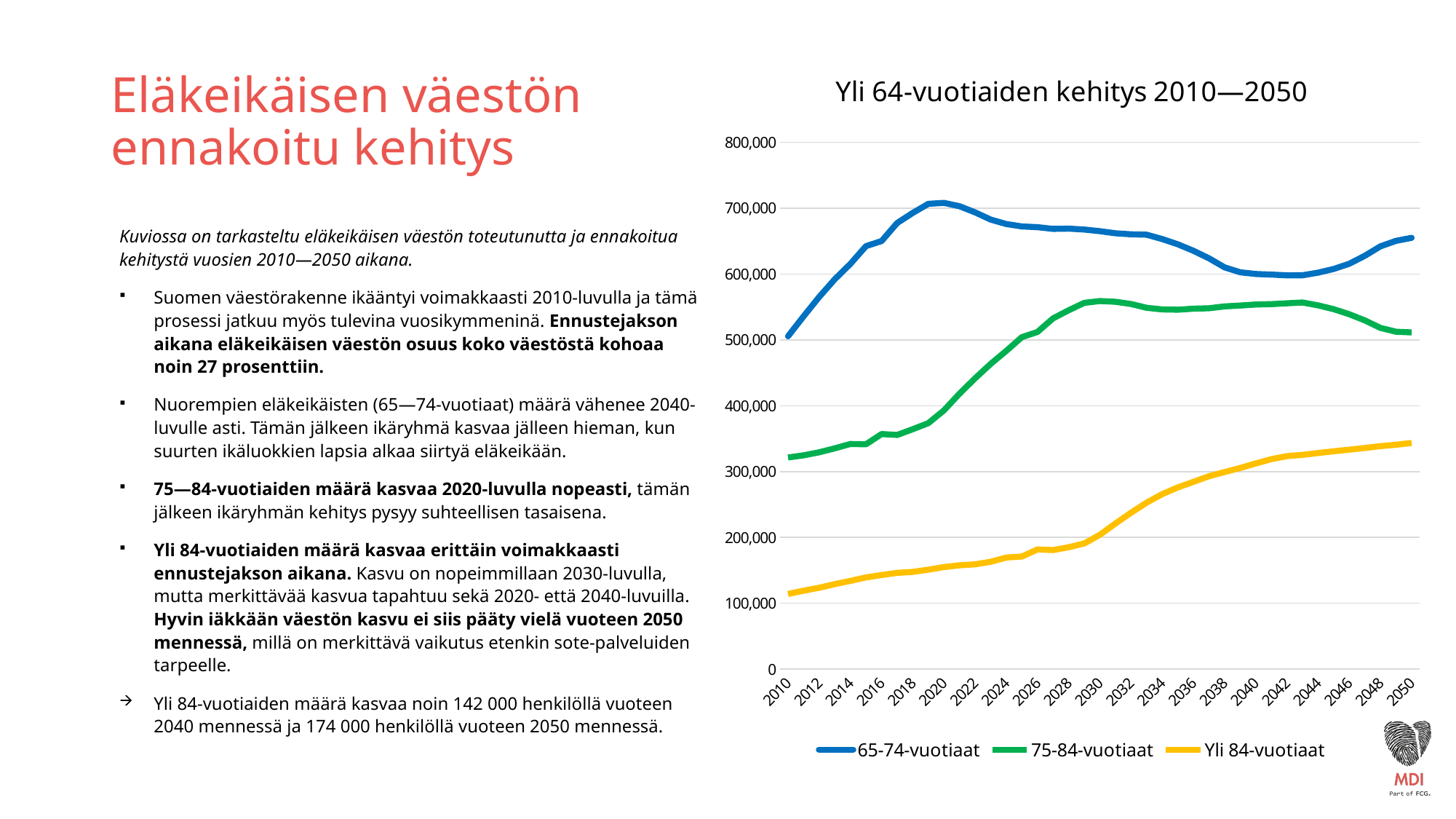
Is the value for 65-74-vuotiaat in 2030 greater or less than 600,000? greater Is the value for 65-74-vuotiaat in 2050 greater or less than 700,000? less Which series is drawn in yellow in the chart? Yli 84-vuotiaat How many series does the chart legend list? 3 Which series has the highest value in 2050? 65-74-vuotiaat Is the value for Yli 84-vuotiaat in 2050 greater or less than 300,000? greater What kind of chart is shown on the slide? line chart In 2050, which is larger: the value for 65-74-vuotiaat or the value for 75-84-vuotiaat? 65-74-vuotiaat What is the title of the chart? Yli 64-vuotiaiden kehitys 2010—2050 Which series has the lowest value in 2010? Yli 84-vuotiaat Does the Yli 84-vuotiaat series rise or fall from 2010 to 2050? rise